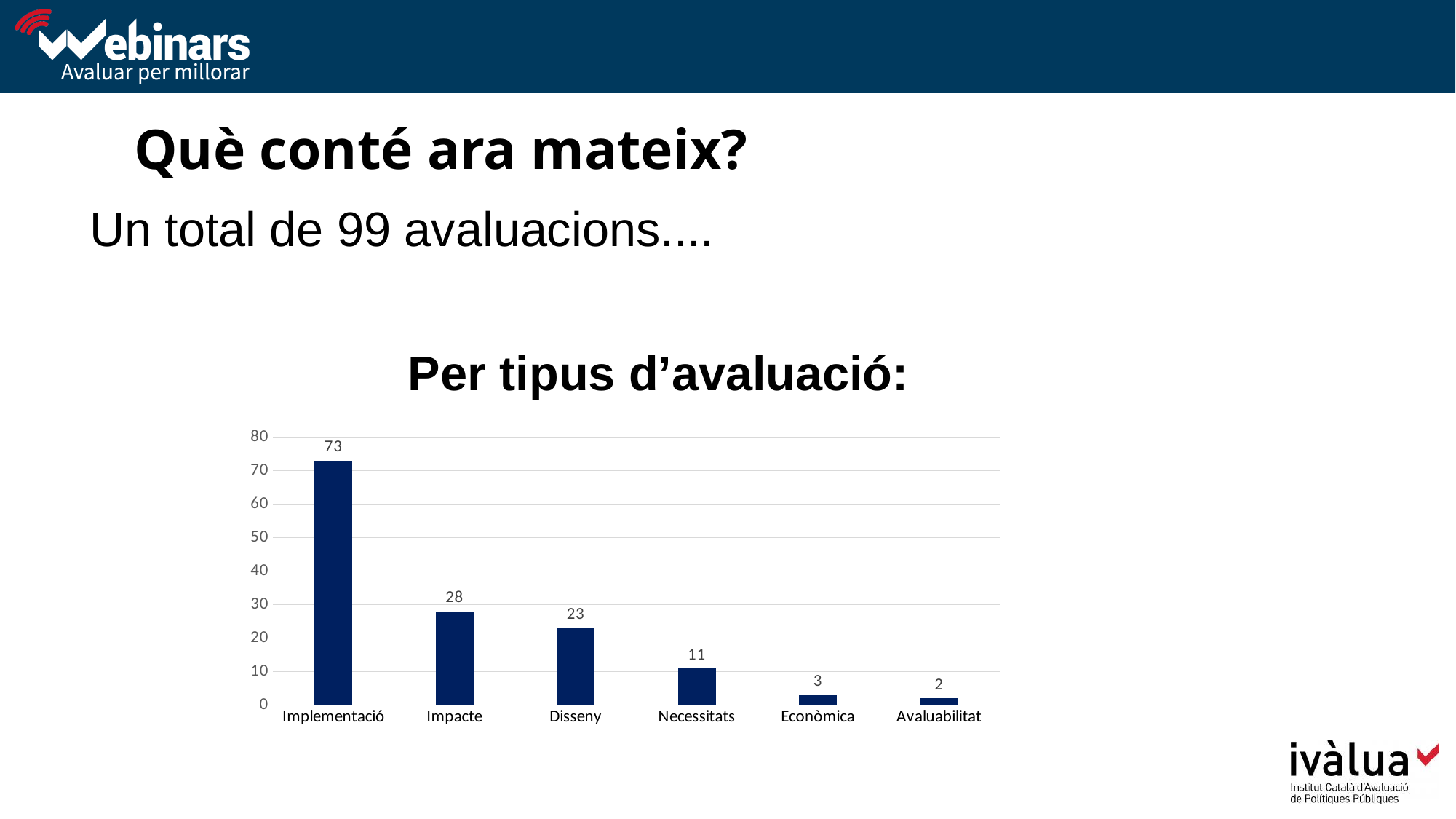
Is the value for Econòmica greater or less than 10? less What is the value for Avaluabilitat? 2 What is the value for Necessitats? 11 Which is larger, the value for Disseny or the value for Necessitats? Disseny Which category has the highest value? Implementació What is the value for Implementació? 73 How many categories are shown on the x axis? 6 What is the value for Impacte? 28 Which category has the lowest value? Avaluabilitat What is the title of the chart? Per tipus d’avaluació: What kind of chart is shown on the slide? bar chart What is the difference between the values for Implementació and Impacte? 45